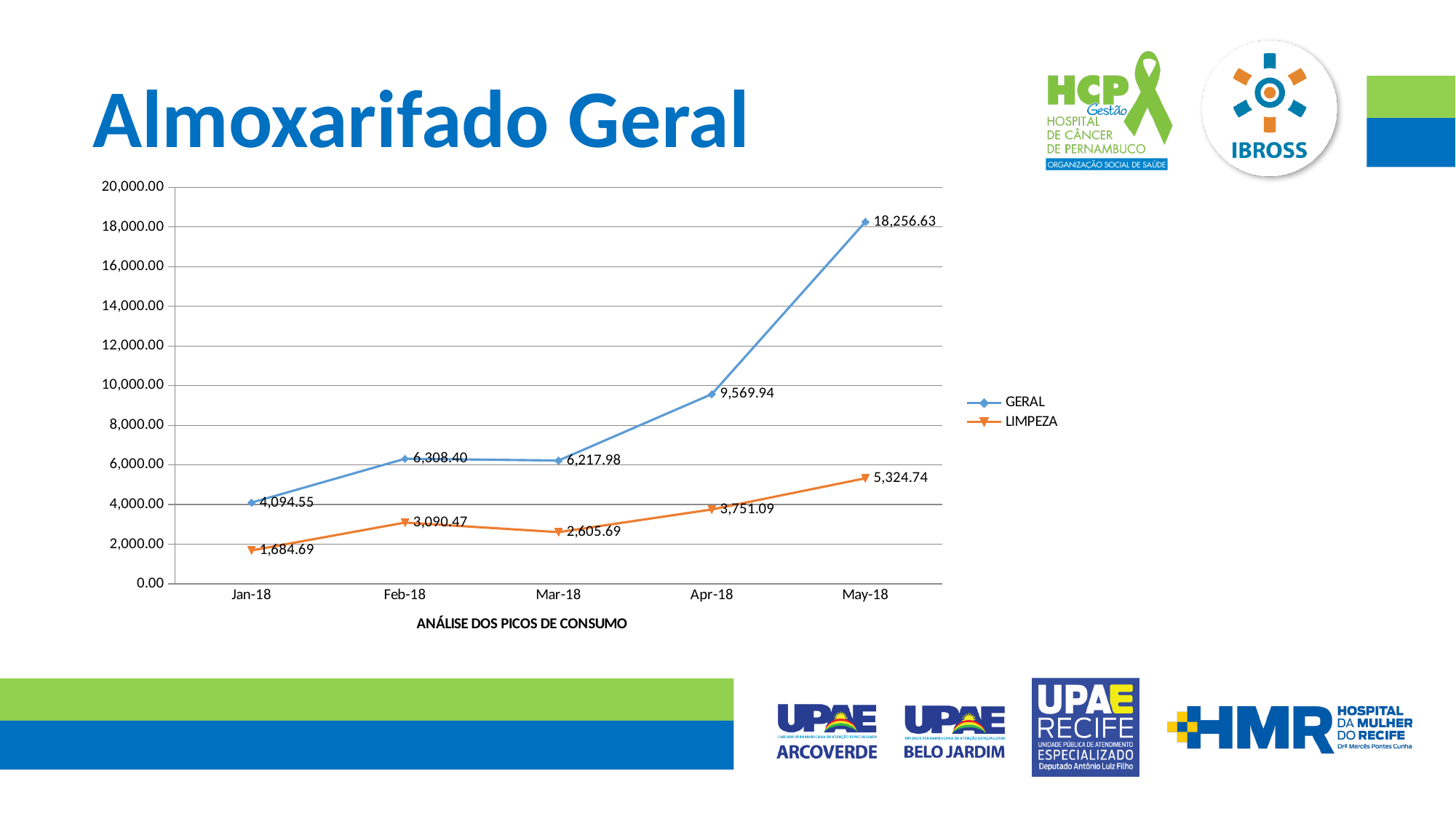
In which month is the GERAL series highest? May-18 What is the LIMPEZA value for Mar-18? 2,605.69 What is the x-axis title of the chart? ANÁLISE DOS PICOS DE CONSUMO What is the difference between the GERAL and LIMPEZA values in May-18? 12,931.89 What is the GERAL value for May-18? 18,256.63 How many series does the legend list? 2 What type of chart is shown on the slide? line chart What is the LIMPEZA value for Jan-18? 1,684.69 How many months are plotted on the x axis? 5 In which month is the LIMPEZA series lowest? Jan-18 What is the GERAL value for Apr-18? 9,569.94 Which is larger in Apr-18, the GERAL value or the LIMPEZA value? GERAL